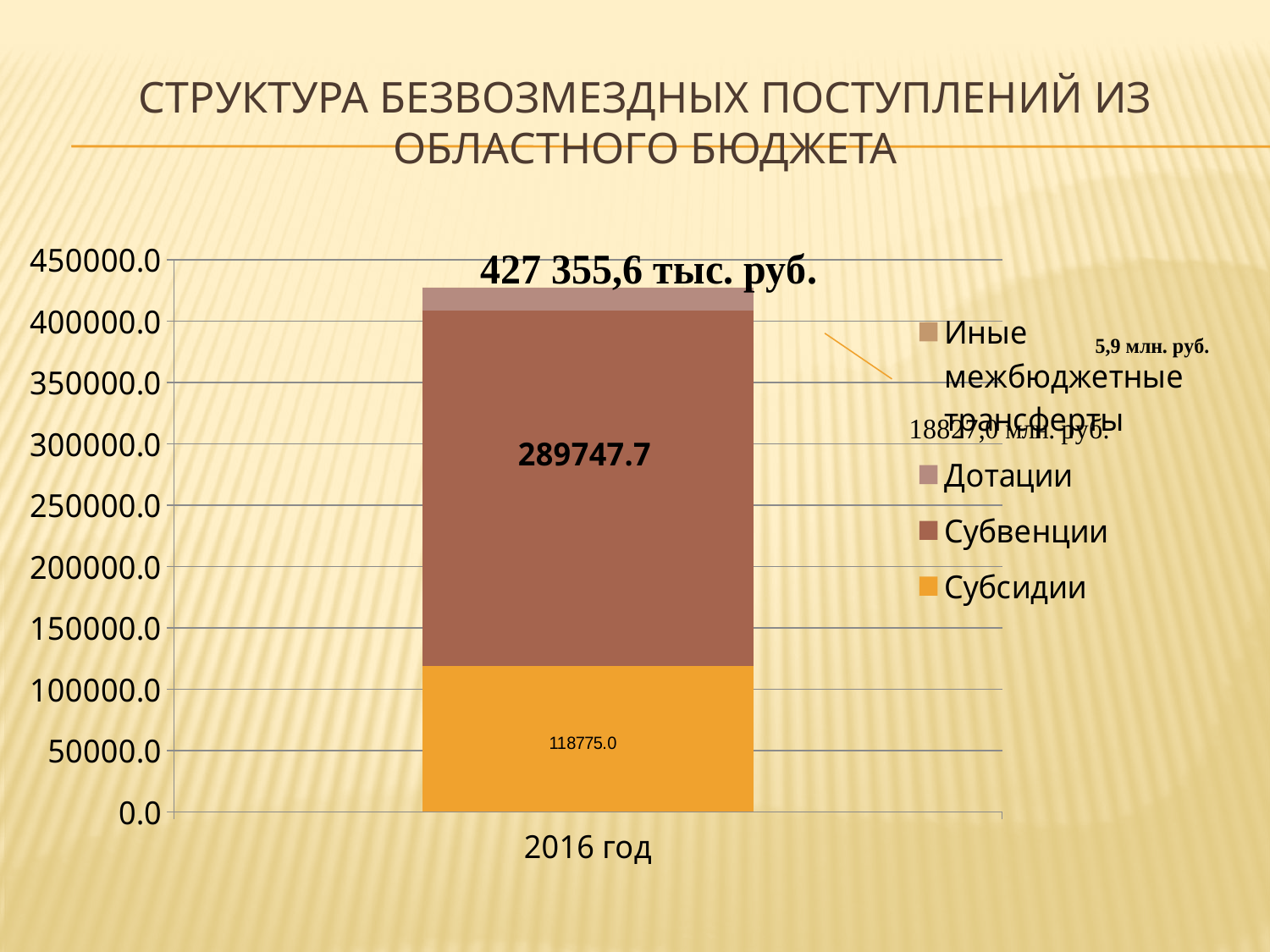
What is the value of the Субсидии segment for 2016 год? 118775.0 Is the value of the Субсидии segment greater or less than 100000? greater What is the title of the chart on the slide? Структура безвозмездных поступлений из областного бюджета What is the category label on the x axis? 2016 год What kind of chart is shown on the slide? stacked bar chart How many categories are shown on the x axis? 1 Which series has the largest segment in the 2016 год bar? Субвенции How many series does the legend list? 4 What is the value of the Субвенции segment for 2016 год? 289747.7 Which is larger, the Субвенции segment or the Субсидии segment? Субвенции What total is printed above the 2016 год bar? 427 355,6 тыс. руб. What is the difference between the Субвенции value and the Субсидии value? 170972.7